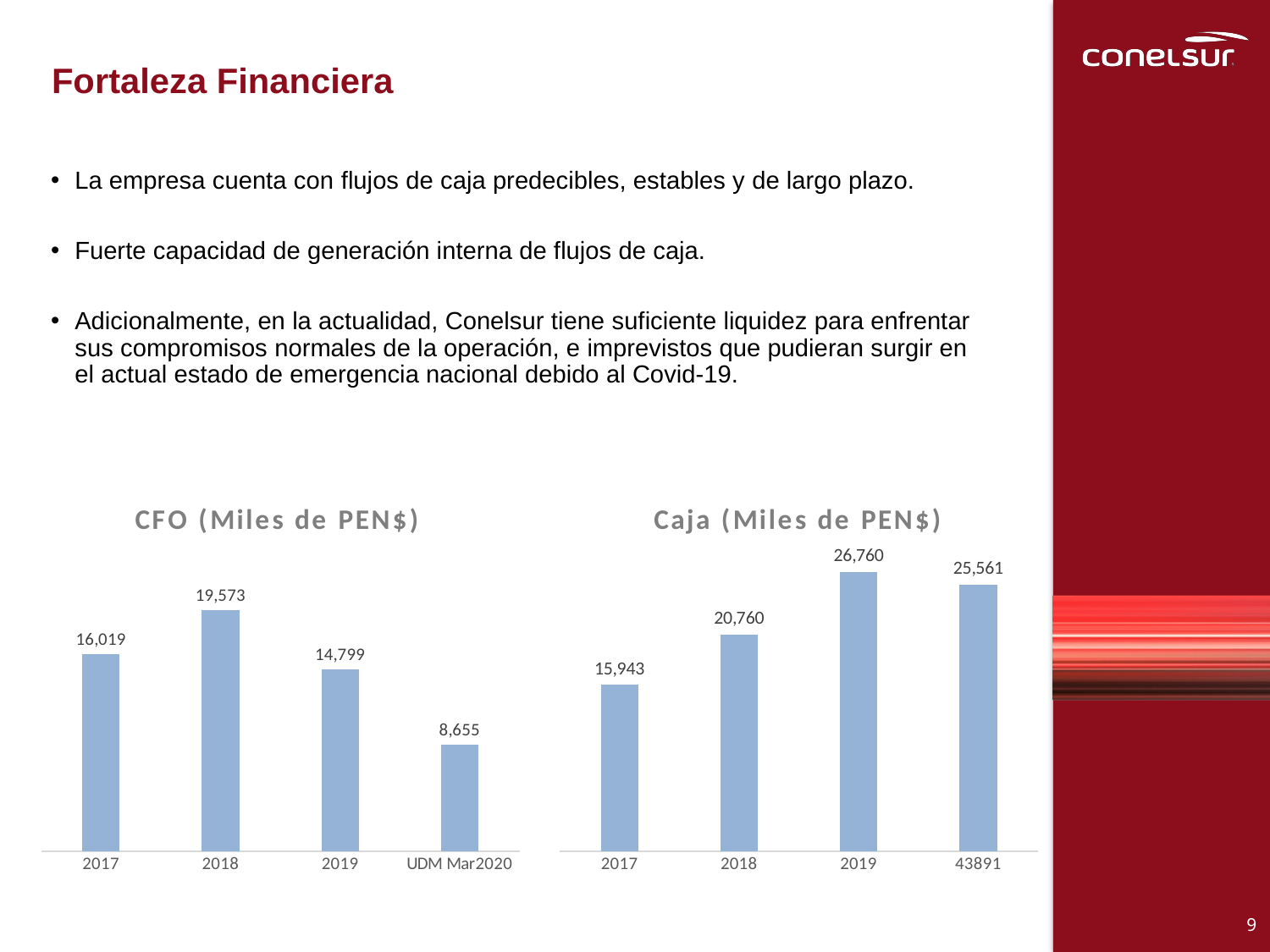
In the Caja (Miles de PEN$) chart, what is the value for 2017? 15,943 In the Caja (Miles de PEN$) chart, what is the value for 2019? 26,760 In the CFO (Miles de PEN$) chart, what is the value for UDM Mar2020? 8,655 What type of chart is the Caja (Miles de PEN$) chart? Bar chart In the Caja (Miles de PEN$) chart, which category has the lowest value? 2017 In the CFO (Miles de PEN$) chart, which category has the lowest value? UDM Mar2020 In the CFO (Miles de PEN$) chart, what is the difference between the 2018 and 2019 values? 4,774 In the CFO (Miles de PEN$) chart, which category has the highest value? 2018 In the Caja (Miles de PEN$) chart, what is the difference between the 2019 and 2018 values? 6,000 In the CFO (Miles de PEN$) chart, what is the value for 2018? 19,573 How many bars are in the CFO (Miles de PEN$) chart? 4 In the Caja (Miles de PEN$) chart, which is larger, the value for 2019 or the value for the last category (43891)? 2019